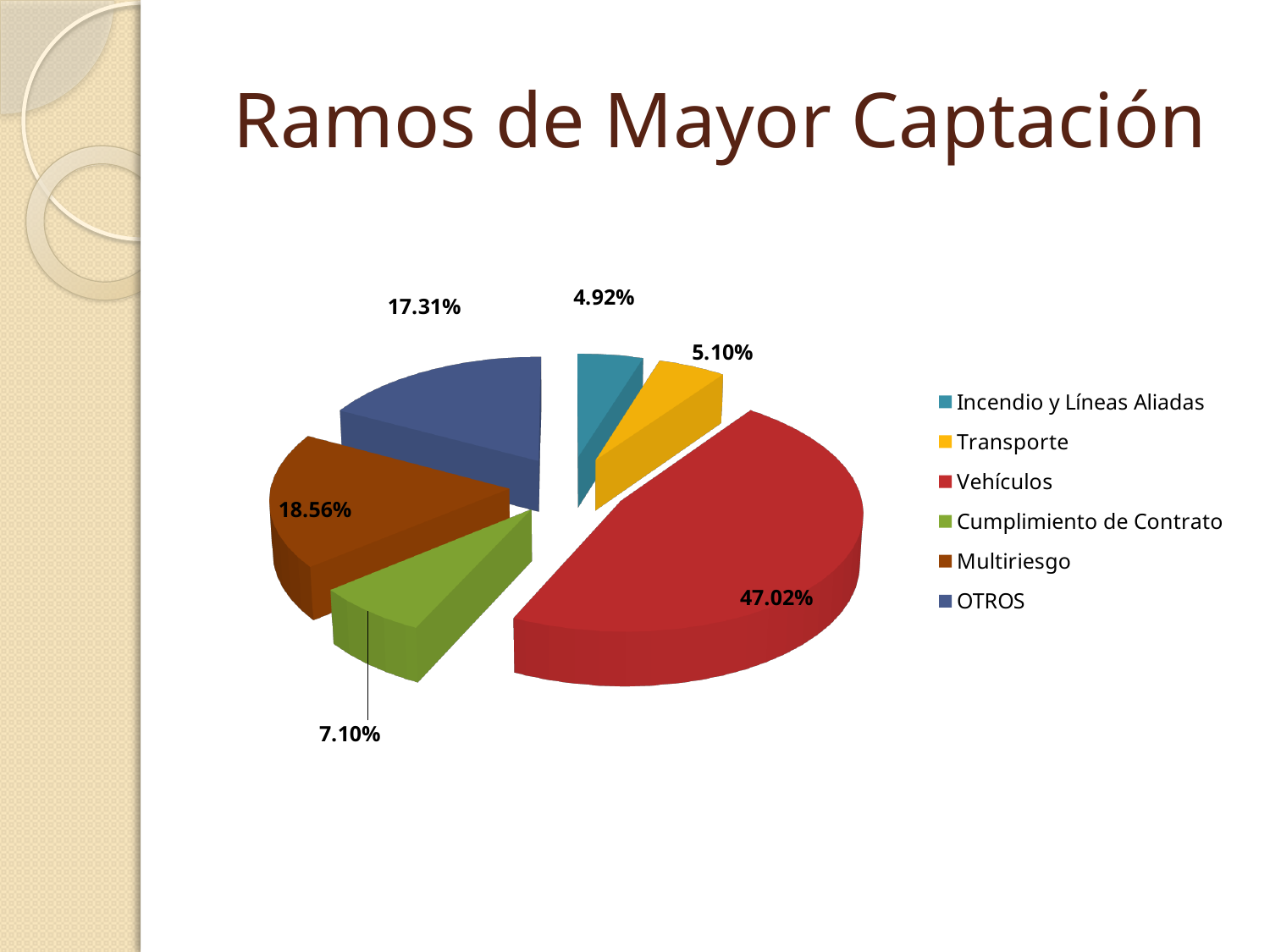
Which is larger, the share for Transporte or the share for Cumplimiento de Contrato? Cumplimiento de Contrato What is the difference in percentage points between Multiriesgo and OTROS? 1.25 What is the share for Incendio y Líneas Aliadas? 4.92% Which category has the largest share of the pie? Vehículos How many categories does the pie chart have? 6 What is the share for Multiriesgo? 18.56% Which category has the smallest share of the pie? Incendio y Líneas Aliadas What is the title of the slide containing the chart? Ramos de Mayor Captación What is the share for Vehículos? 47.02% What is the share for Cumplimiento de Contrato? 7.10% What is the share for OTROS? 17.31% What kind of chart is shown on the slide? Pie chart